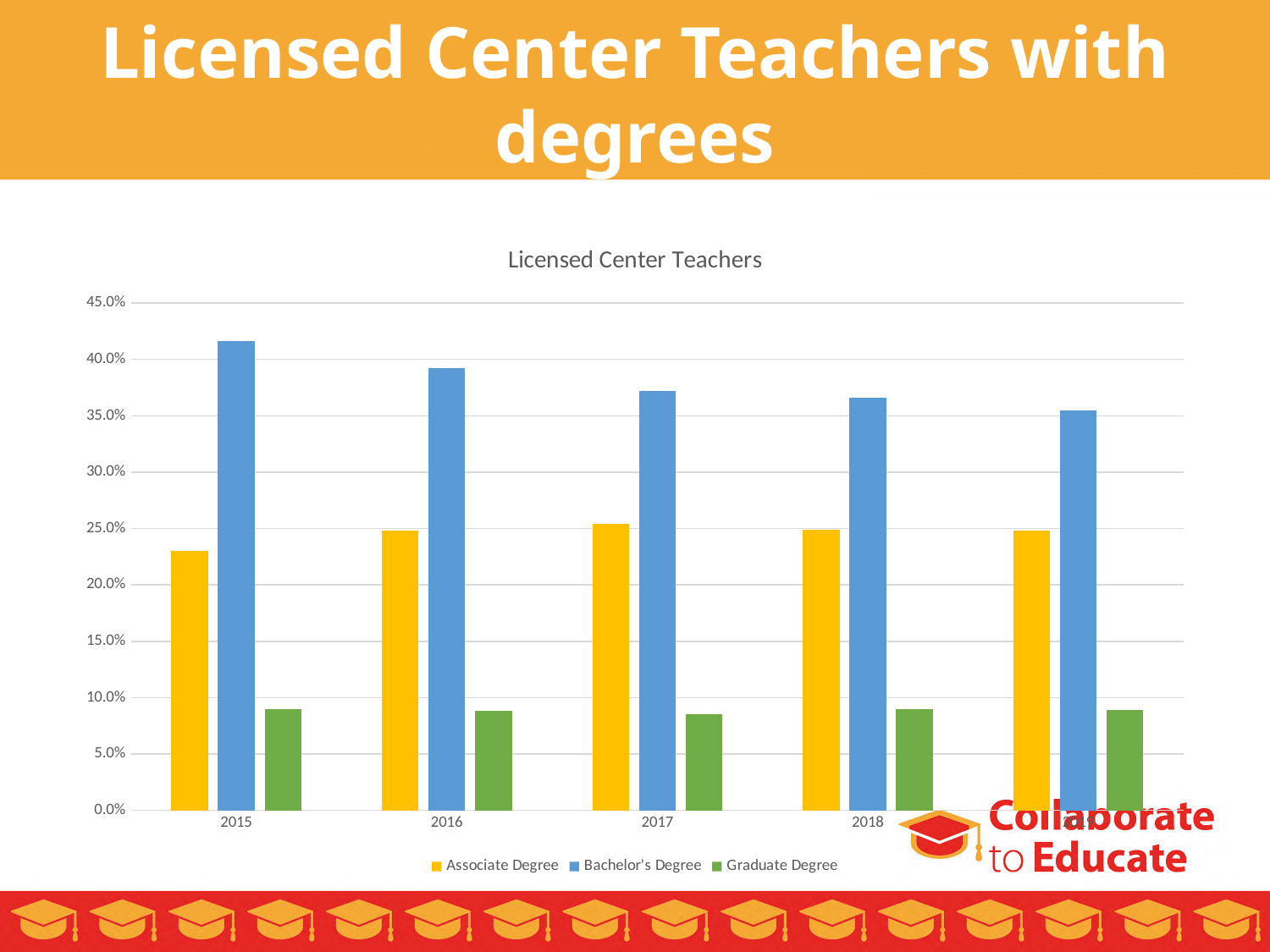
Which degree series has the lowest value in 2017? Graduate Degree Do the Bachelor's Degree values rise or fall from 2015 to 2018? fall Which is larger: Bachelor's Degree in 2015 or Bachelor's Degree in 2016? Bachelor's Degree in 2015 Is the value for Graduate Degree in 2017 greater or less than 10.0%? less Is the value for Associate Degree in 2015 greater or less than 25.0%? less What is the title of the chart? Licensed Center Teachers Is the value for Bachelor's Degree in 2018 greater or less than 35.0%? greater Which degree series has the highest value in 2015? Bachelor's Degree What type of chart is shown on the slide? bar chart How many year groups are plotted on the x axis? 5 How many series does the legend list? 3